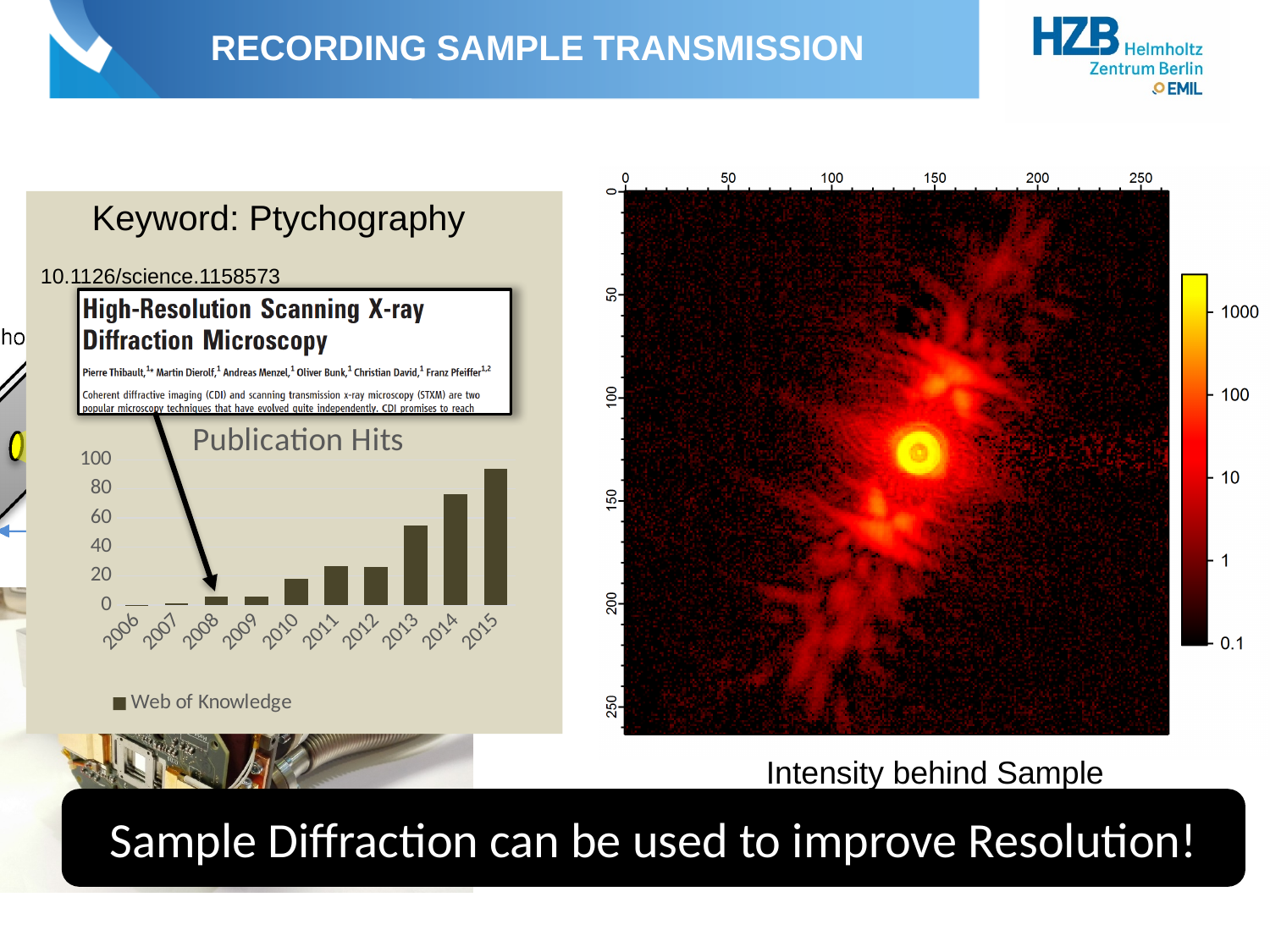
How many series does the legend of the 'Publication Hits' chart list? 1 Do the values in the 'Publication Hits' chart generally rise or fall from 2006 to 2015? rise What is the title of the bar chart on the slide? Publication Hits In the 'Publication Hits' chart, is the value for 2014 greater or less than 60? greater What kind of chart is the 'Publication Hits' chart? bar chart In the 'Publication Hits' chart, is the value for 2013 greater or less than 40? greater In the 'Publication Hits' chart, which is larger, the value for 2014 or the value for 2013? 2014 In the 'Publication Hits' chart, is the value for 2015 greater or less than 80? greater How many years are shown on the x axis of the 'Publication Hits' chart? 10 What is the legend entry of the 'Publication Hits' chart? Web of Knowledge Which year has the highest value in the 'Publication Hits' chart? 2015